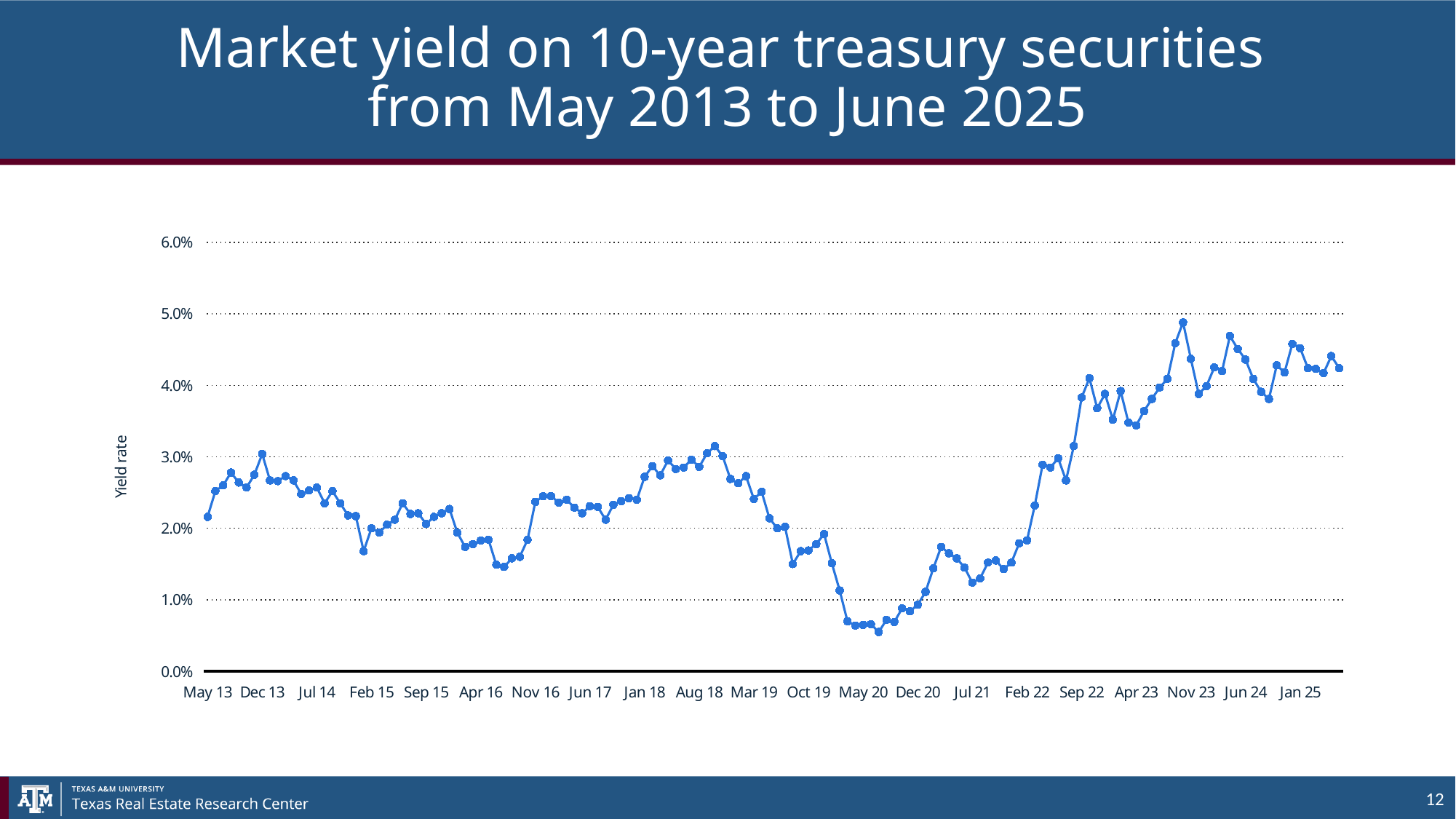
Is the yield rate at May 20 greater or less than 1.0%? less Is the yield rate at May 13 greater or less than 2.0%? greater Does the yield rate rise or fall between Jul 21 and Nov 23? rise Is the yield rate at Jan 25 greater or less than 4.0%? greater What is the label on the vertical axis? Yield rate In which year does the yield rate reach its lowest point on the chart? 2020 What is the title of the chart? Market yield on 10-year treasury securities from May 2013 to June 2025 How many lines (series) are plotted on the chart? 1 What kind of chart is shown on the slide? line chart Which has the higher yield rate, Nov 23 or May 20? Nov 23